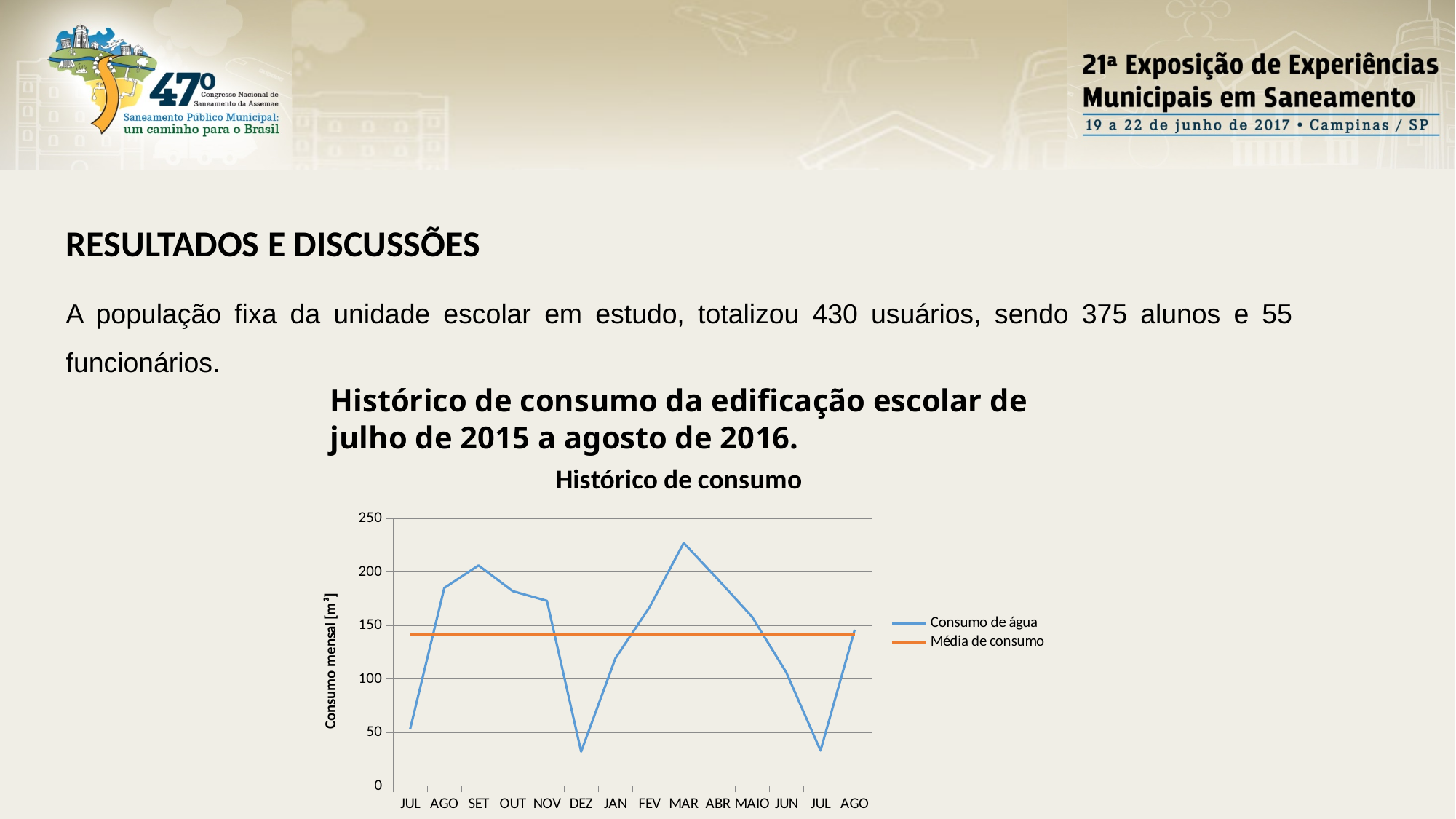
In which month does the 'Consumo de água' series reach its highest value? MAR What kind of chart is shown on the slide? line chart Which is larger, the 'Consumo de água' value for MAR or for SET? MAR How many months are plotted along the x axis of the 'Histórico de consumo' chart? 14 Is the 'Consumo de água' value for JUN greater or less than 150? less Is the 'Consumo de água' value for ABR greater or less than 150? greater What is the label of the y axis of the 'Histórico de consumo' chart? Consumo mensal [m³] Is the 'Consumo de água' value for DEZ greater or less than 50? less Does the 'Consumo de água' series rise or fall from MAR to the second JUL? fall How many series does the legend of the 'Histórico de consumo' chart list? 2